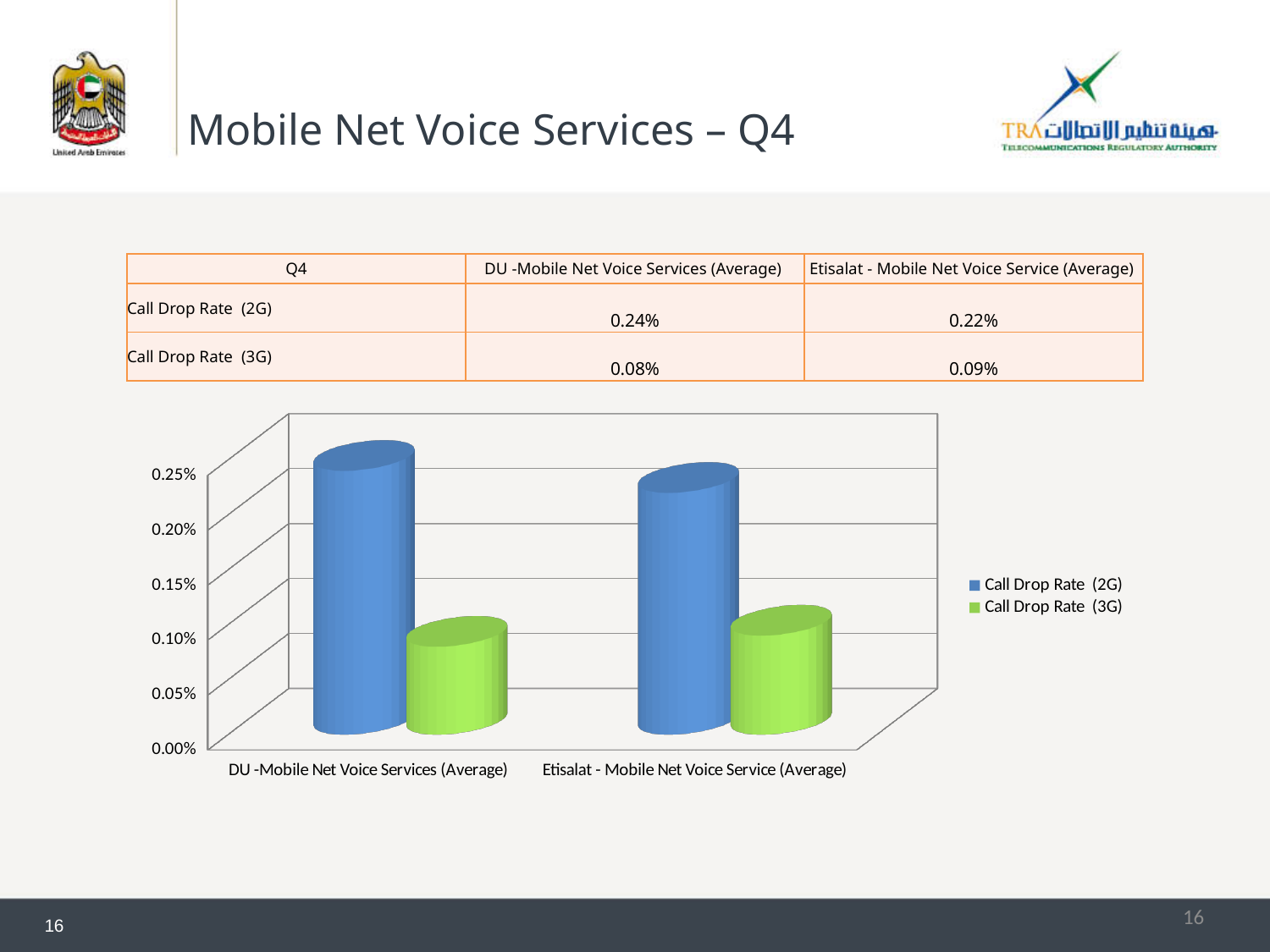
How many series does the chart legend list? 2 What is the Call Drop Rate (3G) for Etisalat - Mobile Net Voice Service (Average)? 0.09% What is the Call Drop Rate (2G) for Etisalat - Mobile Net Voice Service (Average)? 0.22% Which operator has the higher Call Drop Rate (2G)? DU - Mobile Net Voice Services (Average) How many categories are shown on the x axis of the chart? 2 Is the Call Drop Rate (3G) for Etisalat greater or less than 0.15%? less What is the difference between the Call Drop Rate (2G) for DU and for Etisalat? 0.02% Is the Call Drop Rate (2G) for DU greater or less than 0.20%? greater What type of chart is shown on the slide? bar chart Which series is shown in green in the chart? Call Drop Rate (3G) What is the Call Drop Rate (2G) for DU - Mobile Net Voice Services (Average)? 0.24% What is the Call Drop Rate (3G) for DU - Mobile Net Voice Services (Average)? 0.08%